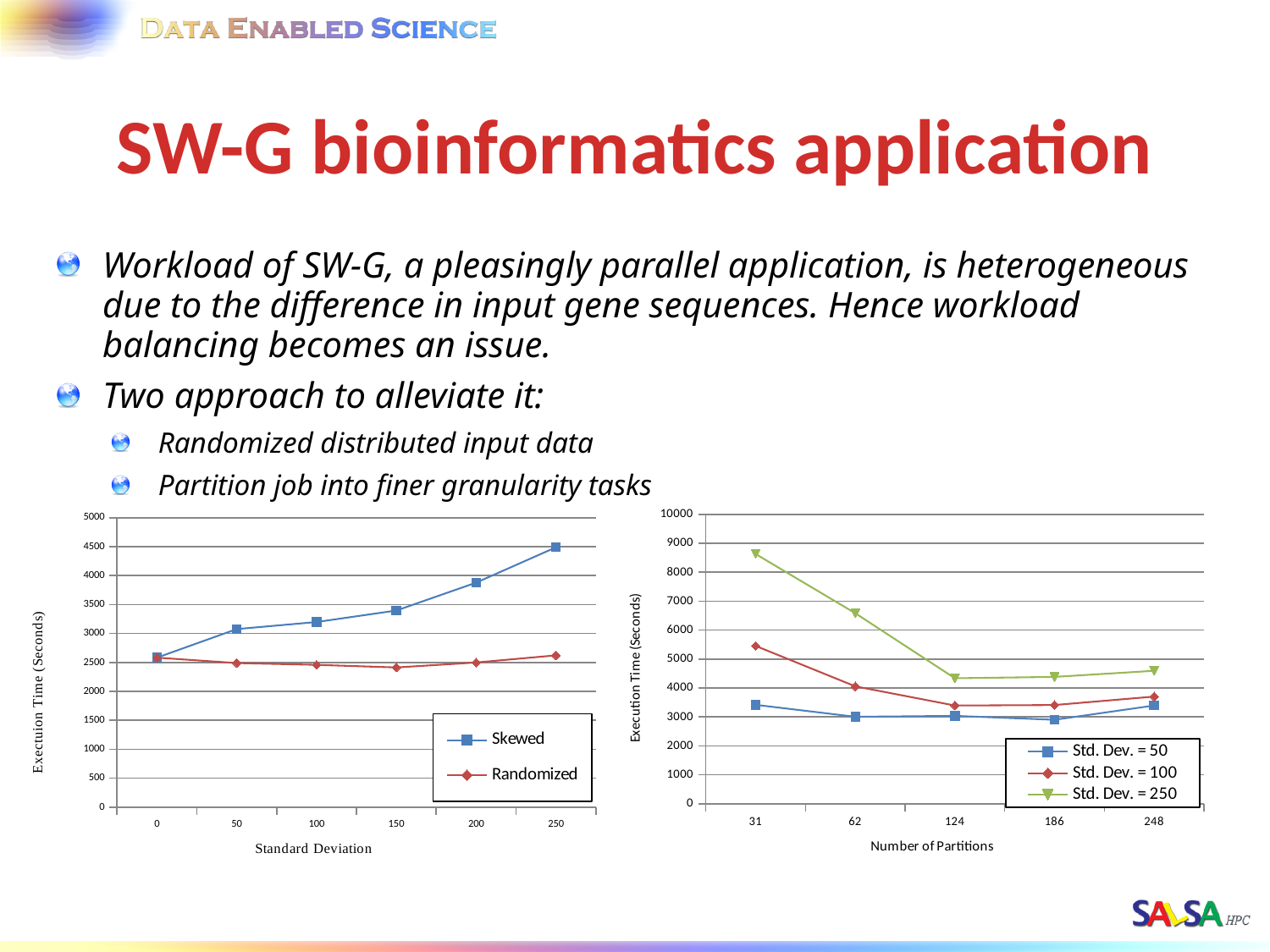
In the left chart (Standard Deviation on the x axis), at which standard deviation does the Skewed series reach its highest value? 250 In the right chart (Number of Partitions on the x axis), is the Std. Dev. = 100 value at 31 partitions greater or less than 5000? greater How many series does the legend of the right chart (Number of Partitions on the x axis) list? 3 How many series does the legend of the left chart (Standard Deviation on the x axis) list? 2 In the right chart (Number of Partitions on the x axis), is the Std. Dev. = 250 value at 31 partitions greater or less than 8000? greater How many x-axis categories (numbers of partitions) are plotted in the right chart? 5 In the left chart (Standard Deviation on the x axis), does the Skewed series rise or fall as standard deviation increases? rise What type of chart is the left chart (Execution Time vs Standard Deviation)? line chart In the right chart (Number of Partitions on the x axis), at 31 partitions, which series has the larger execution time, Std. Dev. = 250 or Std. Dev. = 50? Std. Dev. = 250 In the left chart (Standard Deviation on the x axis), at standard deviation 200, which series has the larger execution time, Skewed or Randomized? Skewed In the left chart (Standard Deviation on the x axis), is the Skewed value at standard deviation 250 greater or less than 4000? greater